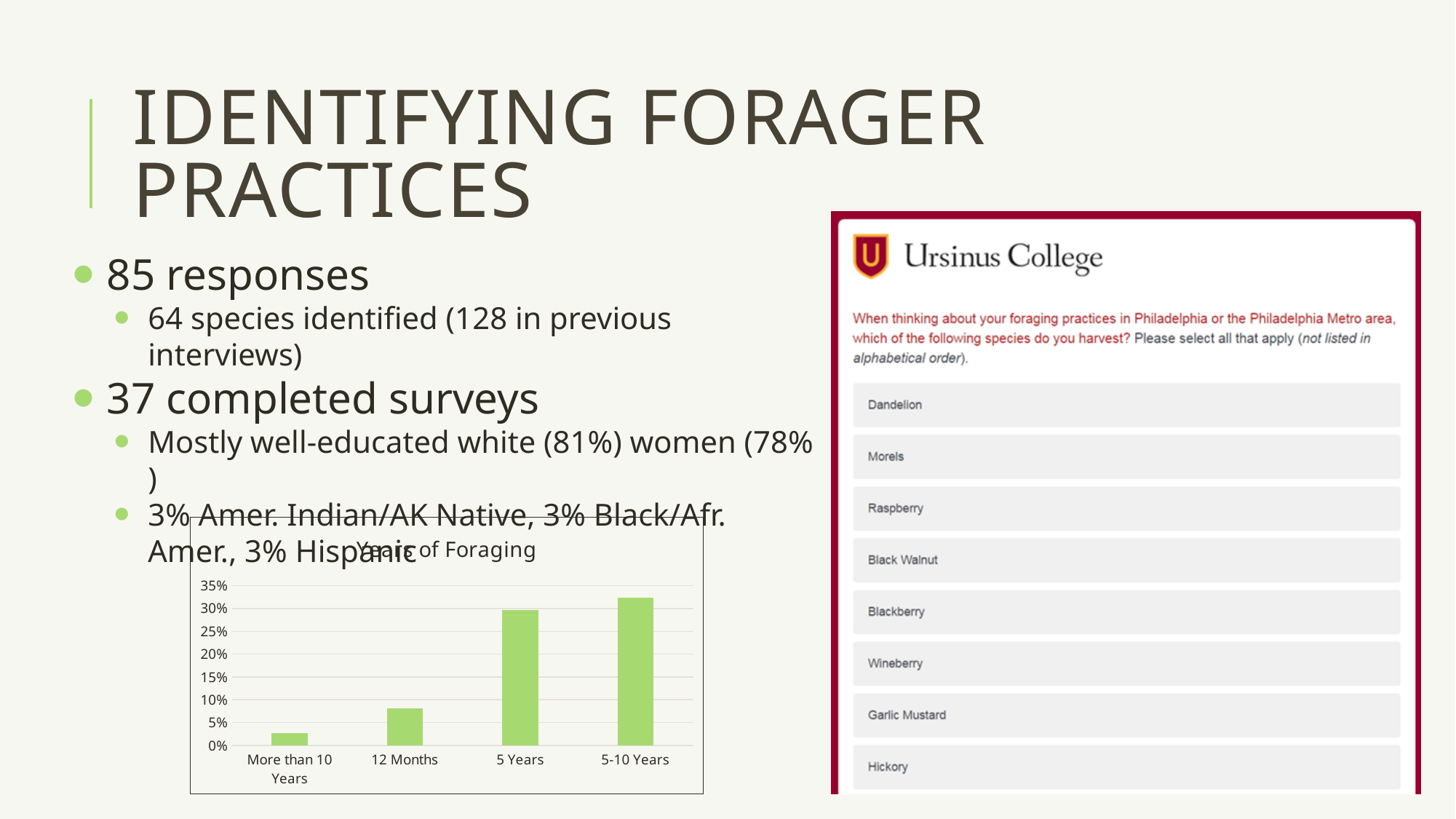
Do the values in the "Years of Foraging" chart rise or fall from left to right along the x axis? rise In the "Years of Foraging" chart, which is larger: the value for 12 Months or the value for 5 Years? 5 Years What is the title of the chart on the slide? Years of Foraging Which category has the lowest value in the "Years of Foraging" chart? More than 10 Years Which category has the highest value in the "Years of Foraging" chart? 5-10 Years In the "Years of Foraging" chart, is the value for 12 Months greater or less than 10%? less How many categories are shown on the x axis of the "Years of Foraging" chart? 4 In the "Years of Foraging" chart, is the value for 5 Years greater or less than 25%? greater What kind of chart is the "Years of Foraging" chart? bar chart In the "Years of Foraging" chart, is the value for More than 10 Years greater or less than 5%? less What is the highest value labelled on the y axis of the "Years of Foraging" chart? 35%